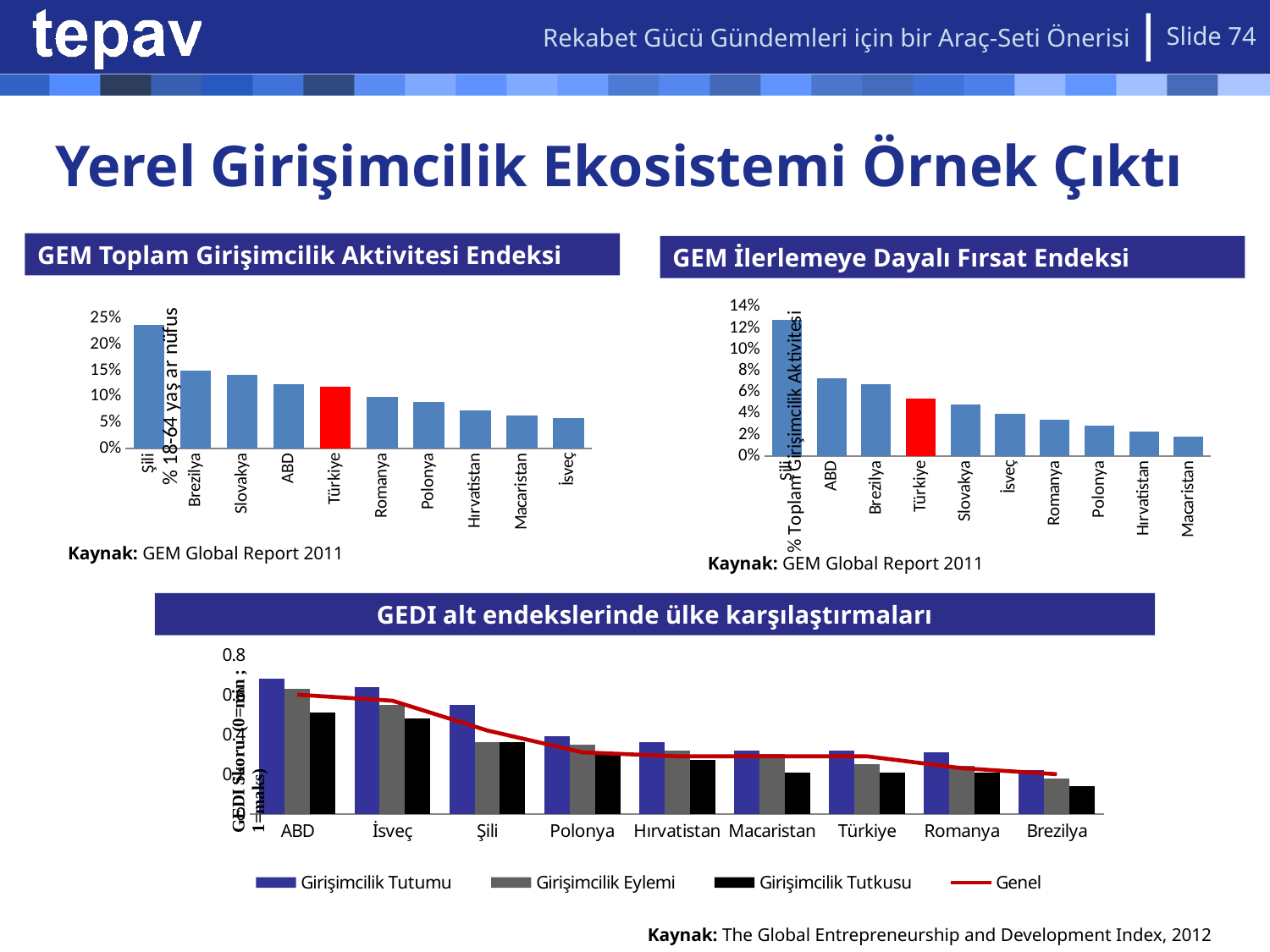
In the chart titled 'GEM İlerlemeye Dayalı Fırsat Endeksi', is the value for Şili greater or less than 10%? greater In the chart titled 'GEM Toplam Girişimcilik Aktivitesi Endeksi', is the value for Türkiye greater or less than 15%? less In the chart titled 'GEM İlerlemeye Dayalı Fırsat Endeksi', which country has the highest value? Şili In the chart titled 'GEDI alt endekslerinde ülke karşılaştırmaları', how many series does the legend list? 4 In the chart titled 'GEM İlerlemeye Dayalı Fırsat Endeksi', which has the larger value, ABD or Türkiye? ABD In the chart titled 'GEM Toplam Girişimcilik Aktivitesi Endeksi', which country has the lowest value? İsveç In the chart titled 'GEM Toplam Girişimcilik Aktivitesi Endeksi', is the value for Şili greater or less than 20%? greater In the chart titled 'GEM Toplam Girişimcilik Aktivitesi Endeksi', what kind of chart is shown? bar chart In the chart titled 'GEM İlerlemeye Dayalı Fırsat Endeksi', which country has the lowest value? Macaristan In the chart titled 'GEM Toplam Girişimcilik Aktivitesi Endeksi', which country has the highest value? Şili In the chart titled 'GEM Toplam Girişimcilik Aktivitesi Endeksi', how many countries are plotted? 10 In the chart titled 'GEDI alt endekslerinde ülke karşılaştırmaları', how many countries are shown on the x axis? 9